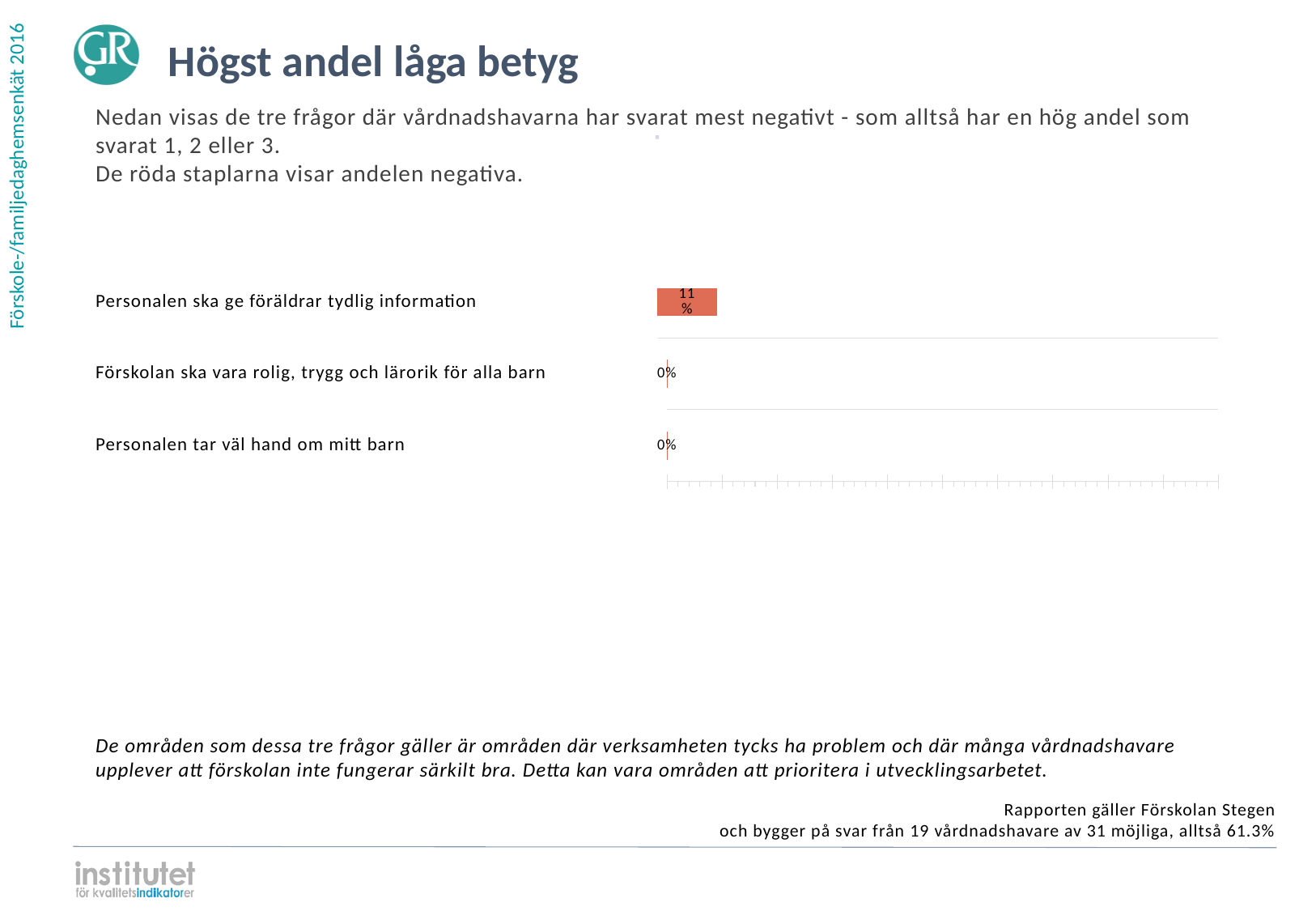
What is the value for "Personalen ska ge föräldrar tydlig information"? 11% How many categories have a value of 0%? 2 What colour are the bars in the chart? Red What kind of chart is shown on the slide? Bar chart How many categories are shown in the chart? 3 What is the value for "Personalen tar väl hand om mitt barn"? 0% What is the difference between the value for "Personalen ska ge föräldrar tydlig information" and the value for "Personalen tar väl hand om mitt barn"? 11% What is the title of the slide containing the chart? Högst andel låga betyg Which category has the highest value? Personalen ska ge föräldrar tydlig information What is the value for "Förskolan ska vara rolig, trygg och lärorik för alla barn"? 0% Which is larger: the value for "Personalen ska ge föräldrar tydlig information" or the value for "Förskolan ska vara rolig, trygg och lärorik för alla barn"? Personalen ska ge föräldrar tydlig information